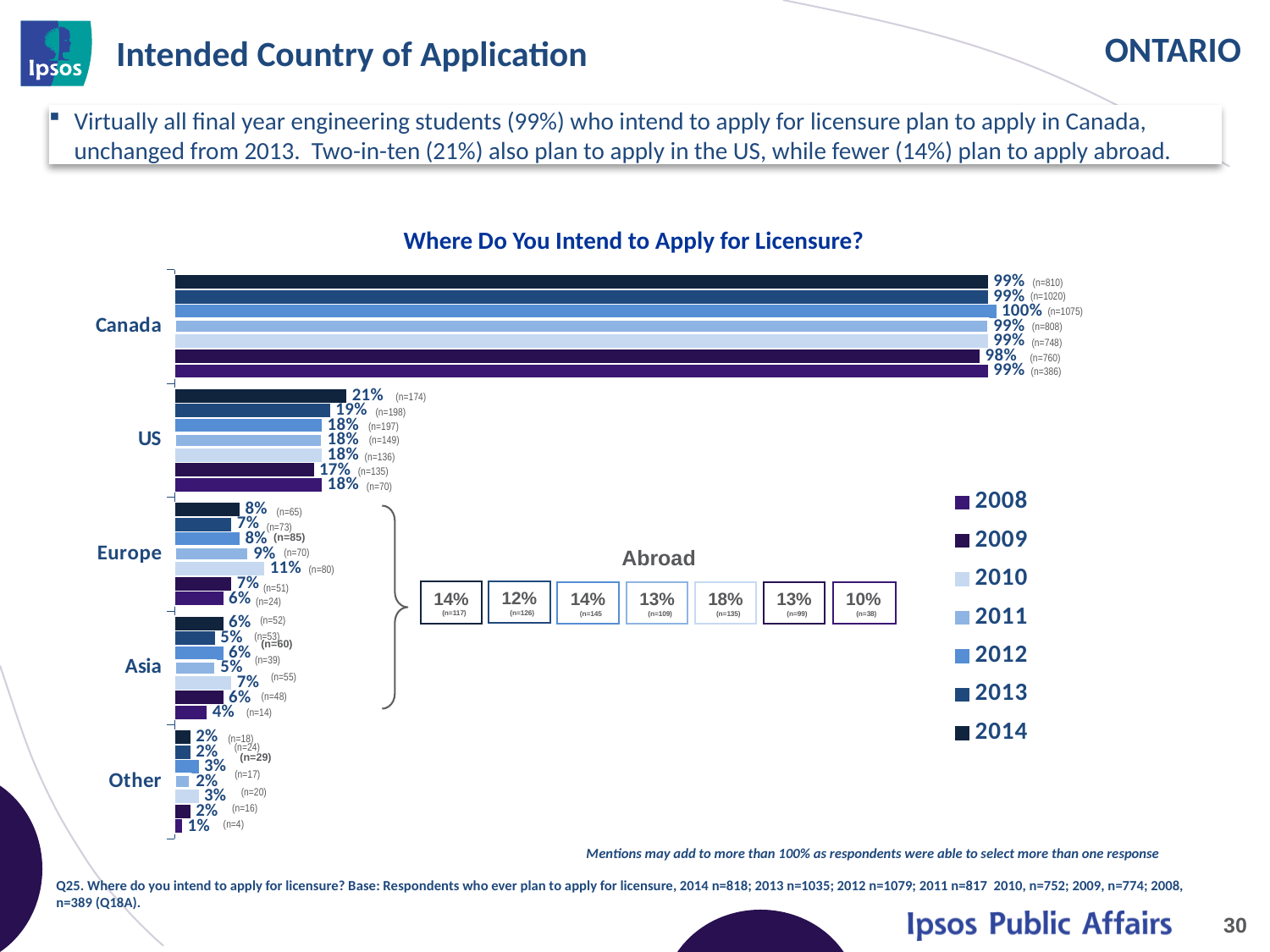
What percentage of students intended to apply in Canada in 2014? 99% Which year had the highest percentage of students intending to apply in the US? 2014 What kind of chart is shown on the slide? bar chart How many country/region categories are shown on the chart's vertical axis? 5 What percentage of students intended to apply in Europe in 2010? 11% What is the difference between the 2014 and 2013 percentages for the US? 2 percentage points What percentage of students intended to apply in 'Other' countries in 2008? 1% In 2014, which category had a higher percentage: Canada or US? Canada What is the title of the chart? Where Do You Intend to Apply for Licensure? Which year had the lowest percentage of students intending to apply in Asia? 2008 What percentage of students intended to apply in the US in 2014? 21% How many years does the chart legend list? 7